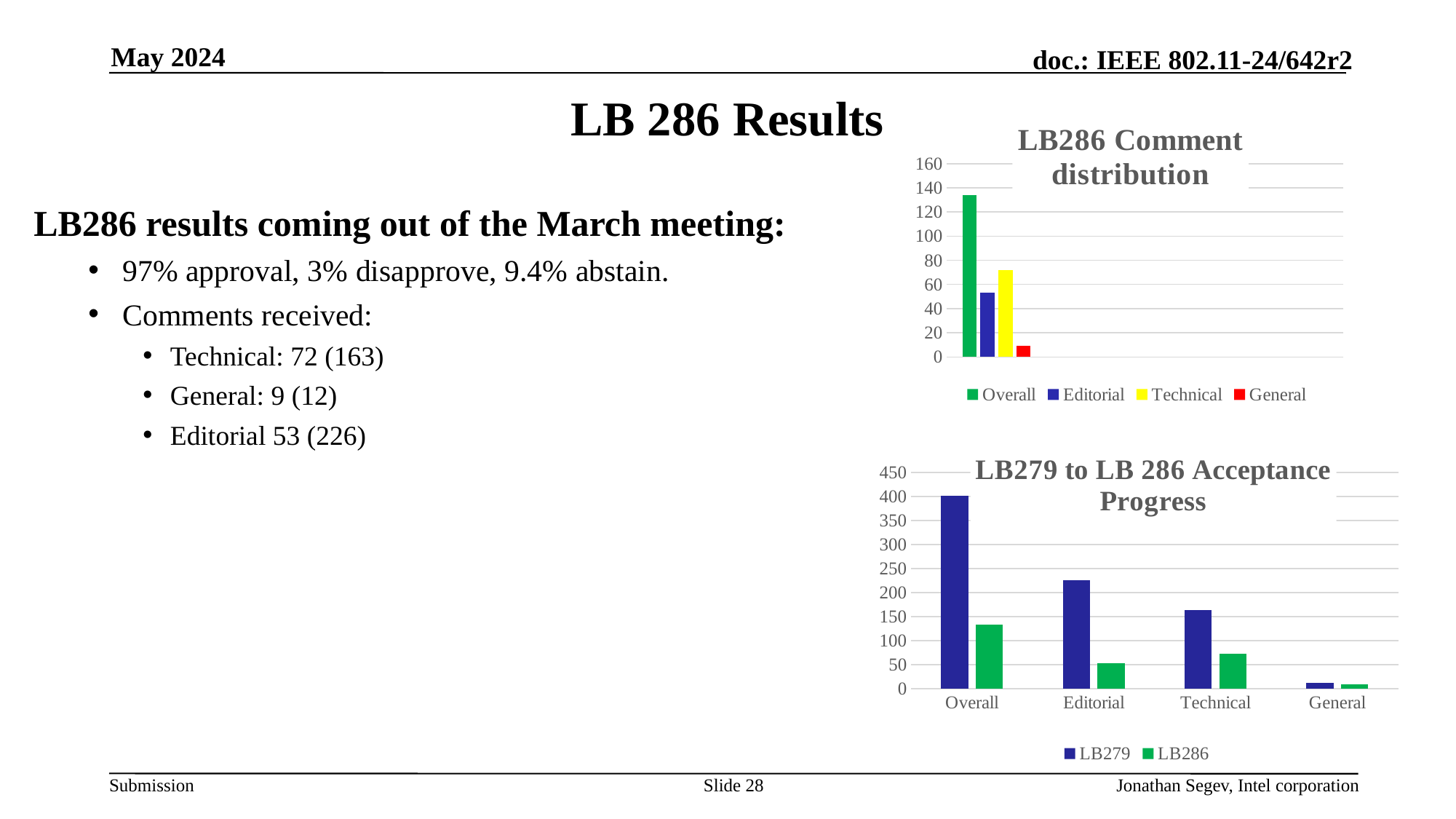
In the 'LB286 Comment distribution' chart, is the value for Technical greater or less than 80? less In the 'LB286 Comment distribution' chart, which series has the lowest bar? General In the 'LB286 Comment distribution' chart, which series has the highest bar? Overall In the 'LB279 to LB 286 Acceptance Progress' chart, which category has the highest LB279 bar? Overall What kind of chart is the 'LB286 Comment distribution' chart? bar chart In the 'LB286 Comment distribution' chart, which is larger, Editorial or Technical? Technical How many series does the legend of the 'LB279 to LB 286 Acceptance Progress' chart list? 2 How many series does the legend of the 'LB286 Comment distribution' chart list? 4 In the 'LB279 to LB 286 Acceptance Progress' chart, which is larger for Editorial, LB279 or LB286? LB279 In the 'LB286 Comment distribution' chart, is the value for Overall greater or less than 120? greater In the 'LB279 to LB 286 Acceptance Progress' chart, is the LB279 value for Overall greater or less than 350? greater How many categories are shown on the x axis of the 'LB279 to LB 286 Acceptance Progress' chart? 4